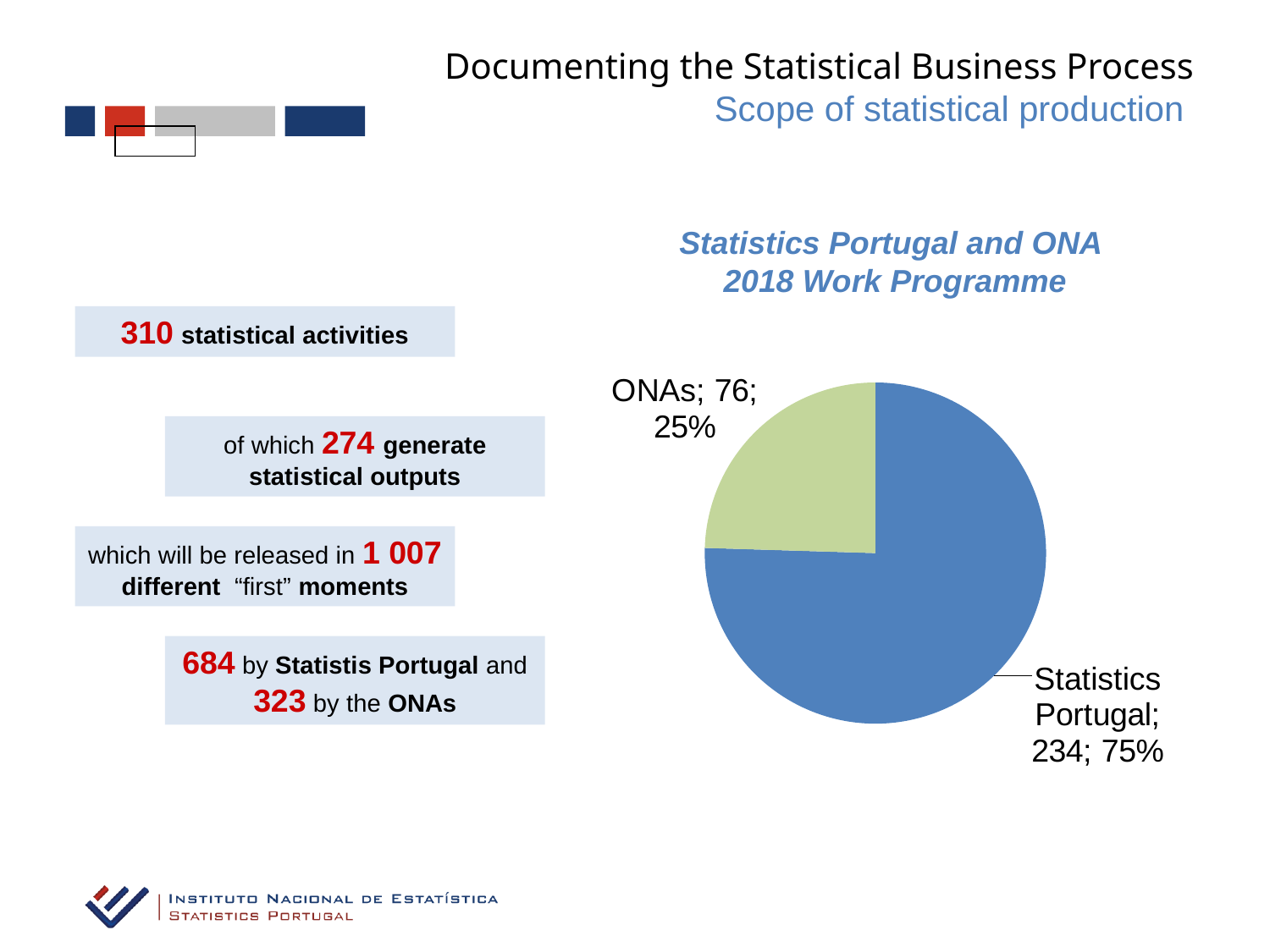
What is the title of the pie chart? Statistics Portugal and ONA 2018 Work Programme Which slice of the pie chart is the smallest? ONAs Which slice of the pie chart is the largest? Statistics Portugal Which is larger, the value for Statistics Portugal or the value for ONAs? Statistics Portugal What kind of chart is shown on the slide? pie chart What share of the pie does Statistics Portugal represent? 75% What is the total of the two values shown in the pie chart? 310 What is the value for ONAs in the pie chart? 76 What is the value for Statistics Portugal in the pie chart? 234 How many slices does the pie chart have? 2 What share of the pie does ONAs represent? 25% What is the difference between the values for Statistics Portugal and ONAs? 158